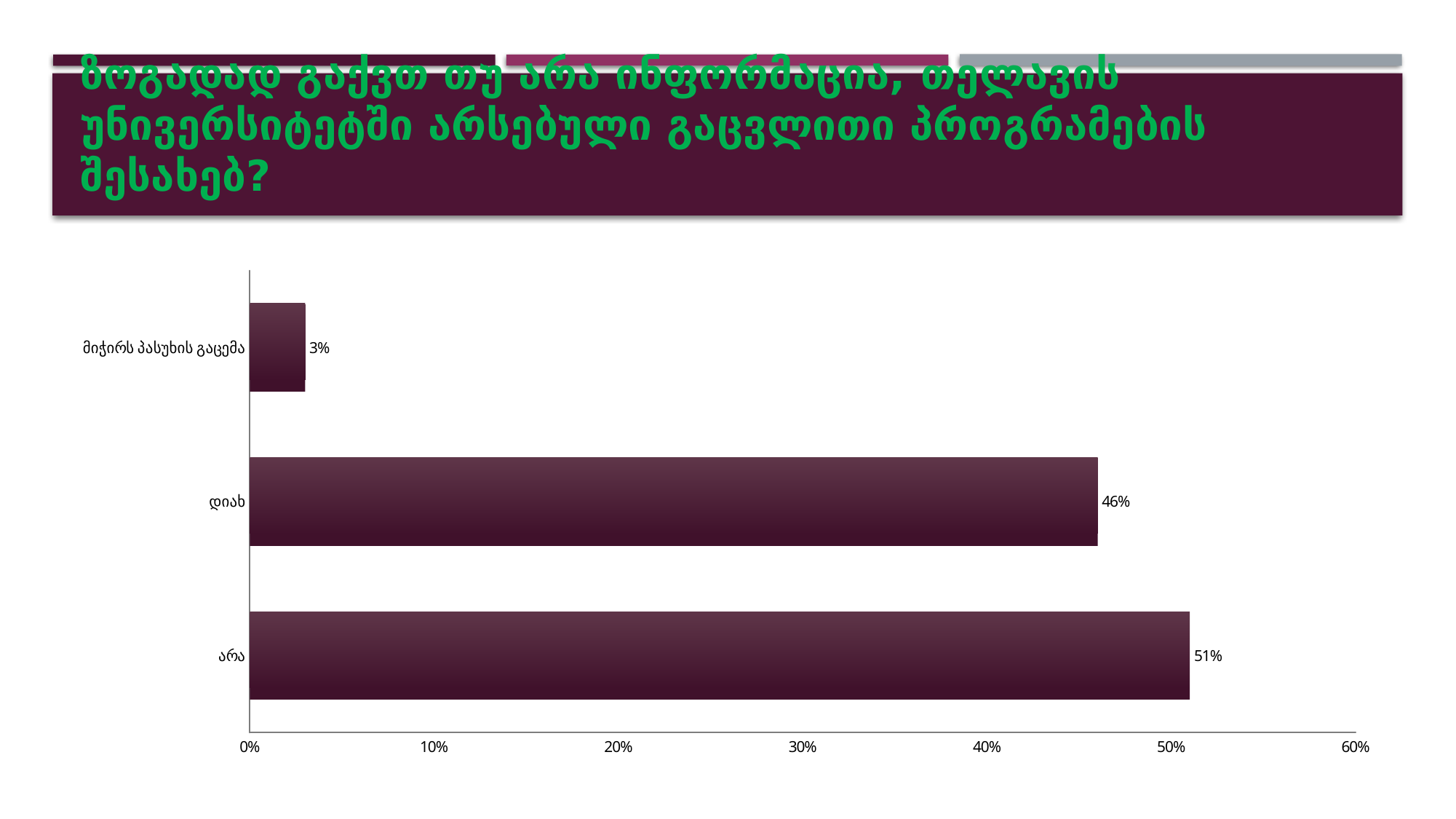
What is the highest value shown on the x axis? 60% Is the value for "დიახ" greater or less than 50%? less What is the difference between the values for "არა" and "დიახ"? 5% What is the value for "მიჭირს პასუხის გაცემა"? 3% How many categories are shown in the chart? 3 Which is larger, the value for "არა" or the value for "დიახ"? არა What is the difference between the values for "დიახ" and "მიჭირს პასუხის გაცემა"? 43% What is the value for "არა"? 51% Which category has the highest value? არა What is the value for "დიახ"? 46% What kind of chart is shown on the slide? bar chart Which category has the lowest value? მიჭირს პასუხის გაცემა